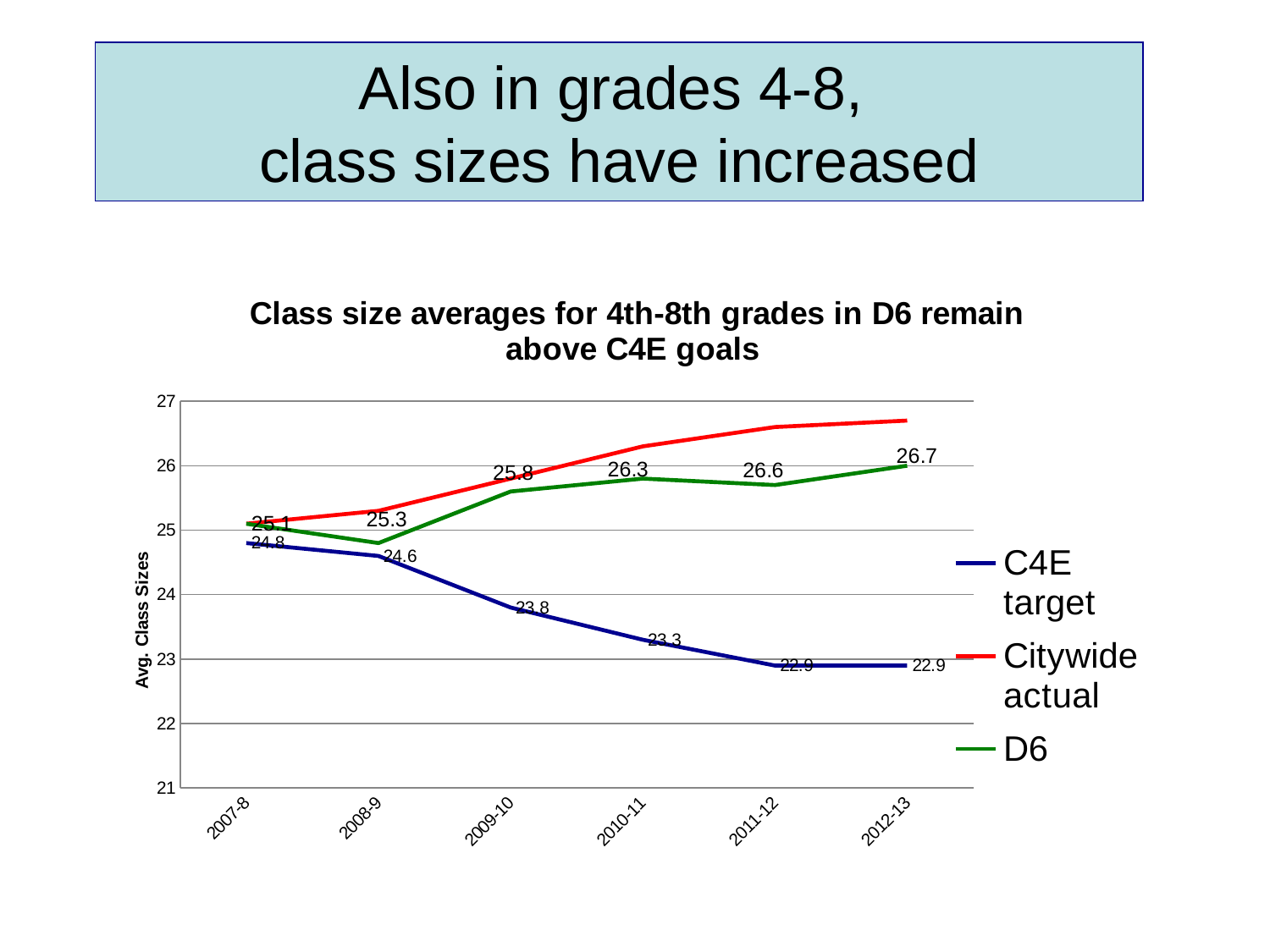
What is the difference between the Citywide actual and the C4E target in 2012-13? 3.8 What is the Citywide actual value for 2012-13? 26.7 What is the C4E target value for 2009-10? 23.8 In which year is the Citywide actual value highest? 2012-13 What is the Citywide actual value for 2008-9? 25.3 In which year is the C4E target value highest? 2007-8 Which is larger in 2010-11, the Citywide actual or the C4E target? Citywide actual Is the D6 value for 2010-11 greater or less than 25? greater What type of chart is shown on the slide? Line chart Does the C4E target rise or fall from 2007-8 to 2012-13? Fall How many series does the legend list? 3 How many school years are plotted along the x axis? 6